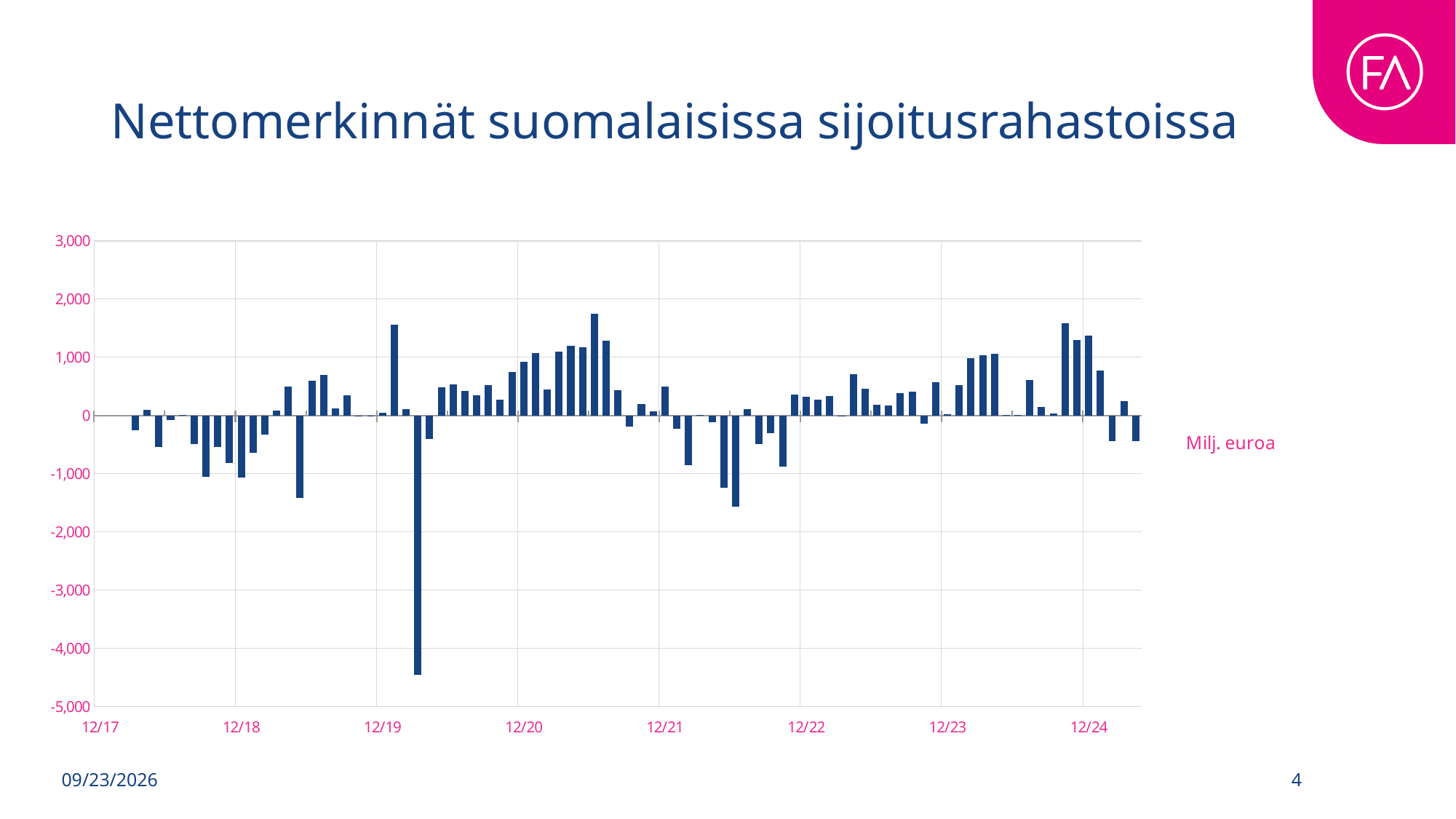
How many labels are shown on the x axis of the chart? 8 Is the lowest bar in the chart greater or less than -5,000? greater What unit label is shown next to the chart? Milj. euroa Is the highest bar in the chart greater or less than 1,000? greater Is the highest bar in the chart greater or less than 2,000? less What kind of chart is shown on the slide? bar chart What is the title of the chart on the slide? Nettomerkinnät suomalaisissa sijoitusrahastoissa What is the highest value shown on the y axis of the chart? 3,000 Is the lowest bar in the chart located between the 12/19 and 12/20 labels or between the 12/21 and 12/22 labels? between 12/19 and 12/20